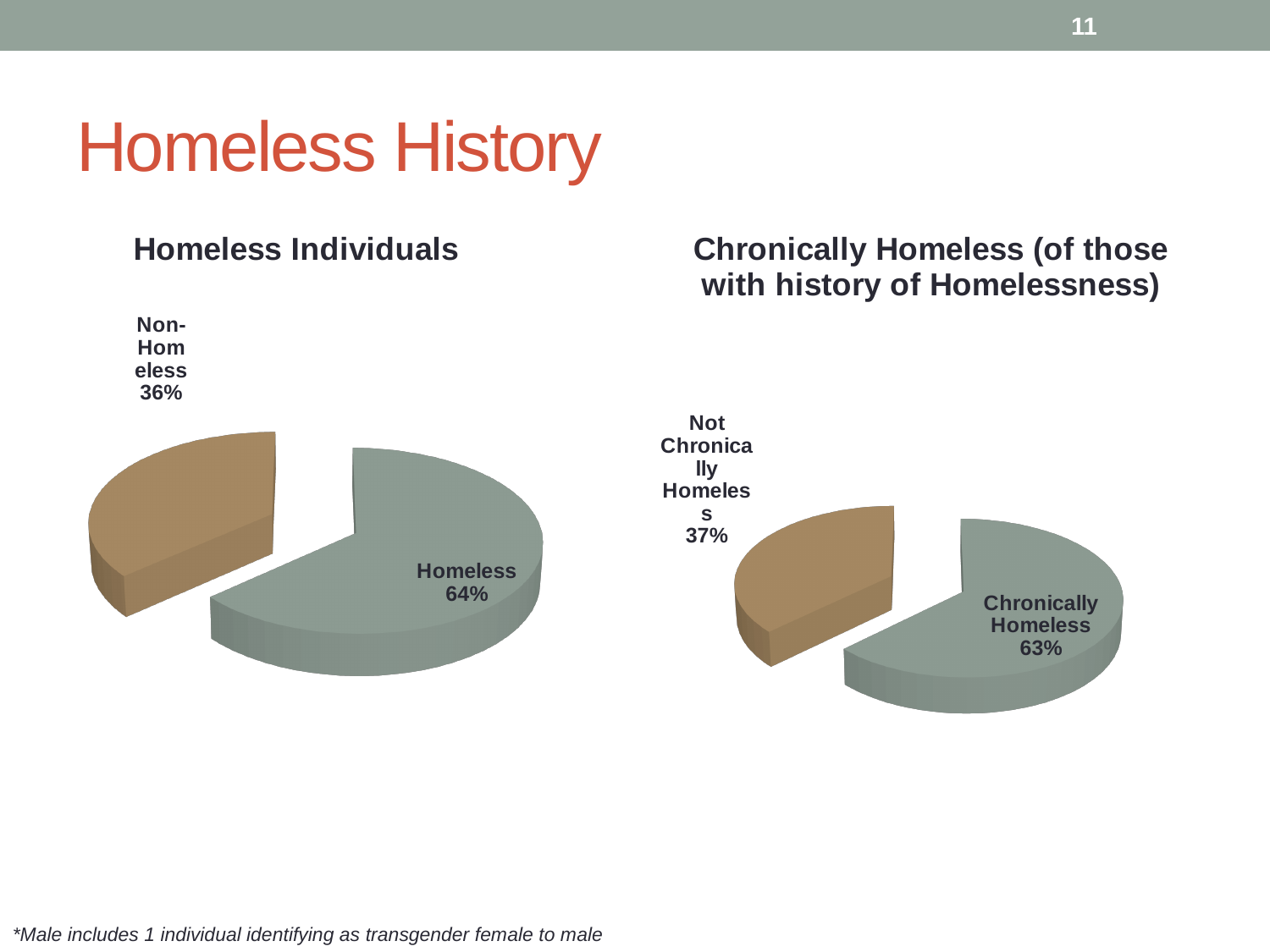
In the 'Homeless Individuals' chart, which is larger: the Homeless slice or the Non-Homeless slice? Homeless In the 'Chronically Homeless (of those with history of Homelessness)' chart, which slice is the smallest? Not Chronically Homeless How many slices does the 'Homeless Individuals' chart have? 2 In the 'Homeless Individuals' chart, what percentage of individuals are Homeless? 64% In the 'Chronically Homeless (of those with history of Homelessness)' chart, what share is Chronically Homeless? 63% In the 'Homeless Individuals' chart, what percentage of individuals are Non-Homeless? 36% In the 'Homeless Individuals' chart, which slice is the largest? Homeless In the 'Homeless Individuals' chart, what is the difference in percentage points between the Homeless and Non-Homeless slices? 28 In the 'Chronically Homeless (of those with history of Homelessness)' chart, what is the difference in percentage points between the Chronically Homeless and Not Chronically Homeless slices? 26 In the 'Chronically Homeless (of those with history of Homelessness)' chart, what share is Not Chronically Homeless? 37% How many charts are shown on the slide? 2 What type of chart is the 'Chronically Homeless (of those with history of Homelessness)' chart? Pie chart